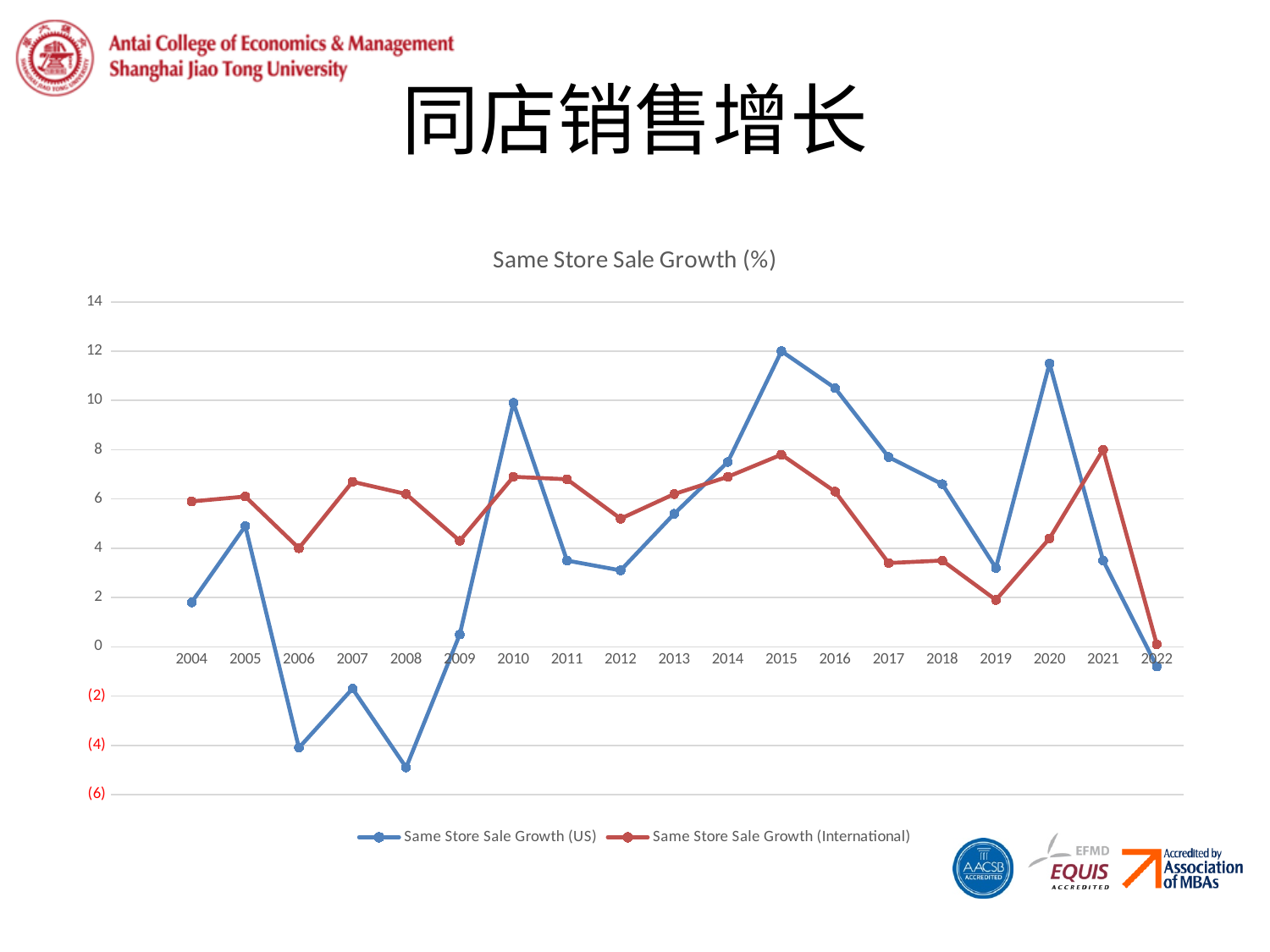
In 2006, which series is higher: Same Store Sale Growth (US) or Same Store Sale Growth (International)? Same Store Sale Growth (International) In which year does Same Store Sale Growth (US) reach its lowest value? 2008 In which year does Same Store Sale Growth (US) reach its highest value? 2015 Is the value for Same Store Sale Growth (US) in 2020 greater or less than 10? greater In which year does Same Store Sale Growth (International) reach its lowest value? 2022 In which year does Same Store Sale Growth (International) reach its highest value? 2021 In 2010, which series is higher: Same Store Sale Growth (US) or Same Store Sale Growth (International)? Same Store Sale Growth (US) How many series does the legend list? 2 Does Same Store Sale Growth (US) rise or fall from 2015 to 2019? fall What kind of chart is shown on the slide? line chart How many years are plotted along the x axis? 19 Is the value for Same Store Sale Growth (International) in 2017 greater or less than 4? less